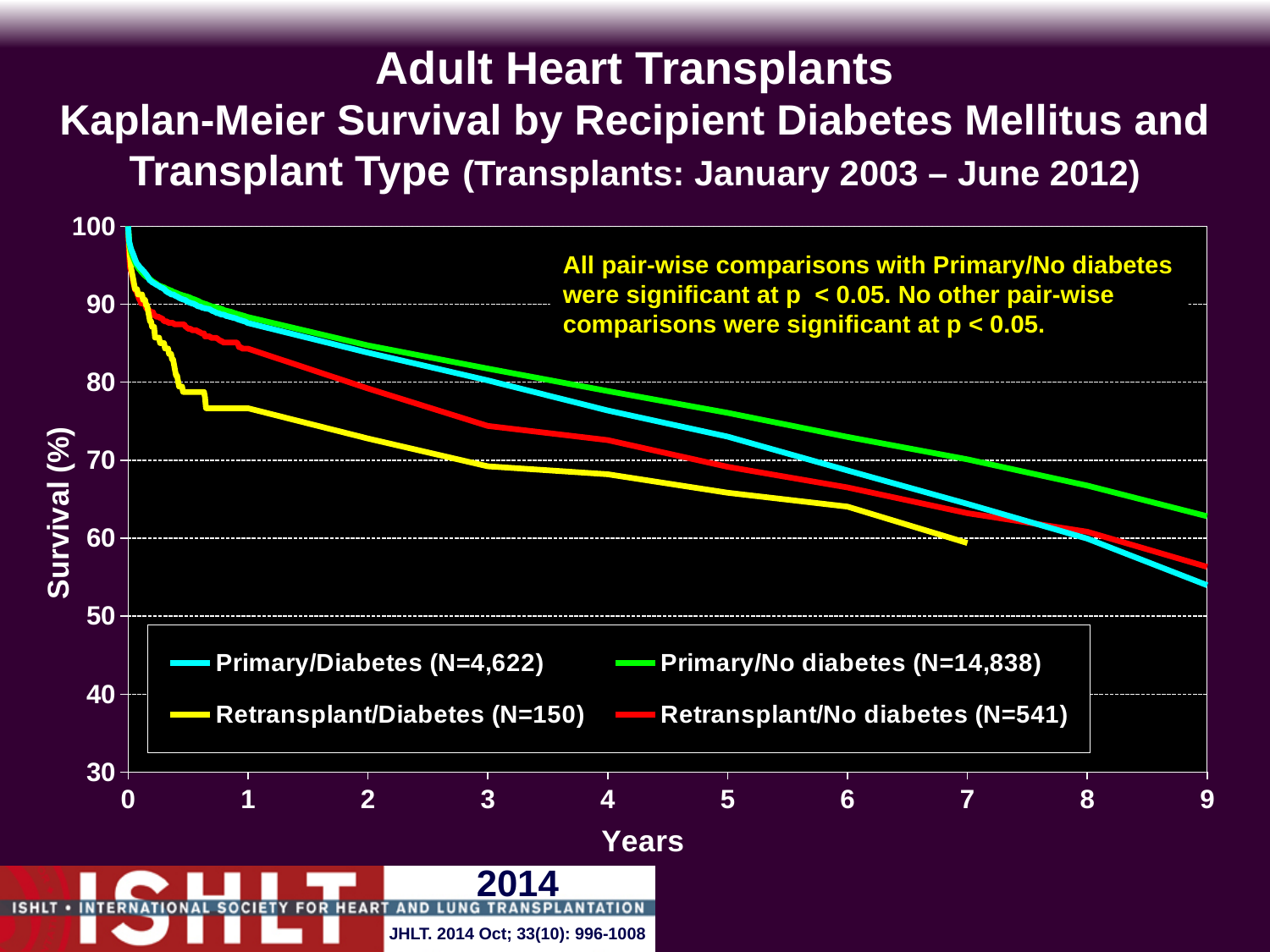
Which series has the lowest survival at year 1? Retransplant/Diabetes (N=150) What is the label of the x axis? Years Is the survival for Primary/Diabetes at year 9 greater or less than 60? less Is the survival for Retransplant/Diabetes at year 1 greater or less than 80? less At year 9, which has higher survival: Primary/No diabetes or Primary/Diabetes? Primary/No diabetes Is the survival for Primary/No diabetes at year 5 greater or less than 70? greater What kind of chart is shown on the slide? Line chart What is the N for the Primary/No diabetes series in the legend? 14,838 Do the survival curves rise or fall as years increase? Fall How many series does the legend list? 4 Which series has the highest survival at year 9? Primary/No diabetes (N=14,838)